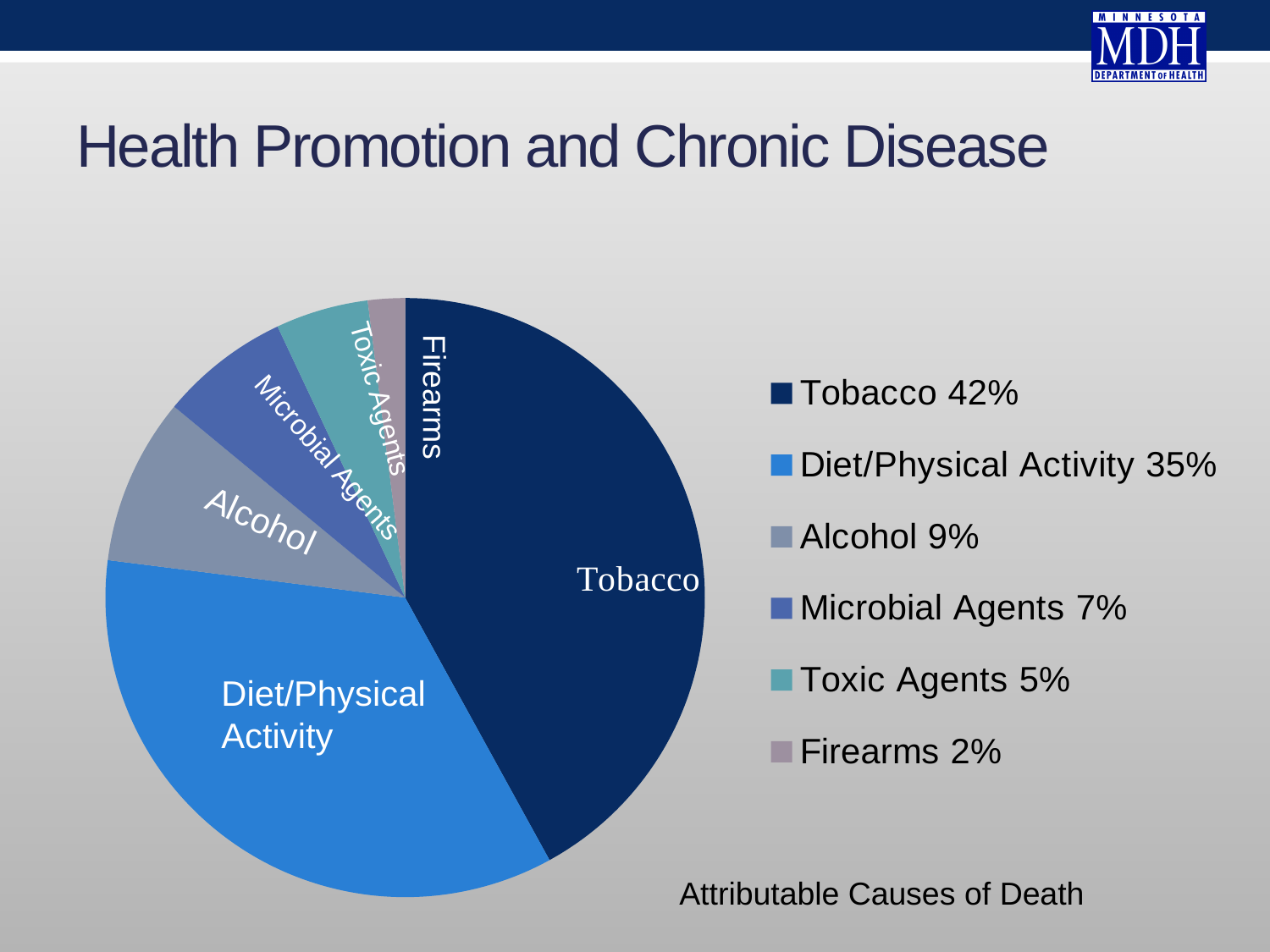
What share of attributable causes of death is Tobacco? 42% Which is larger, Alcohol or Toxic Agents? Alcohol What is the combined percentage of Tobacco and Diet/Physical Activity? 77% What is the caption below the pie chart? Attributable Causes of Death What percentage is shown for Microbial Agents? 7% What is the difference in percentage points between Tobacco and Diet/Physical Activity? 7 Which category has the largest slice of the pie? Tobacco What percentage is shown for Firearms? 2% What kind of chart is shown on the slide? pie chart Which category has the smallest slice of the pie? Firearms How many categories does the pie chart show? 6 What percentage is shown for Diet/Physical Activity? 35%